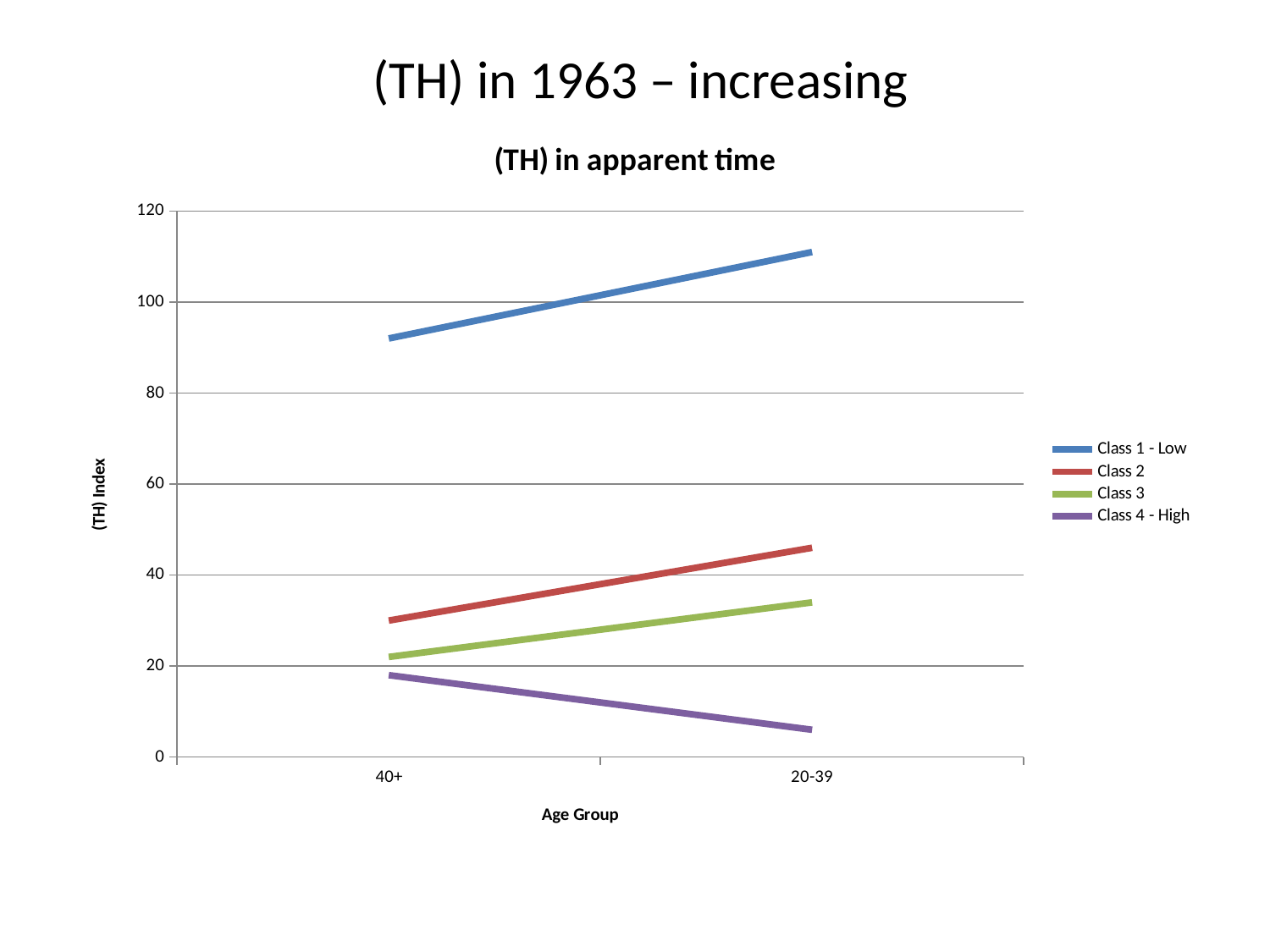
What kind of chart is shown on the slide? line chart How many series does the legend list? 4 Is the value for Class 1 - Low at 40+ greater or less than 100? less Does the value for Class 4 - High rise or fall from 40+ to 20-39? fall Does the value for Class 2 rise or fall from 40+ to 20-39? rise What is the title of the chart? (TH) in apparent time Which series has the highest value at 20-39? Class 1 - Low Does the value for Class 1 - Low rise or fall from 40+ to 20-39? rise How many age groups are shown on the x axis? 2 Is the value for Class 1 - Low at 20-39 greater or less than 100? greater Which series has the lowest value at 40+? Class 4 - High Is the value for Class 4 - High at 20-39 greater or less than 20? less